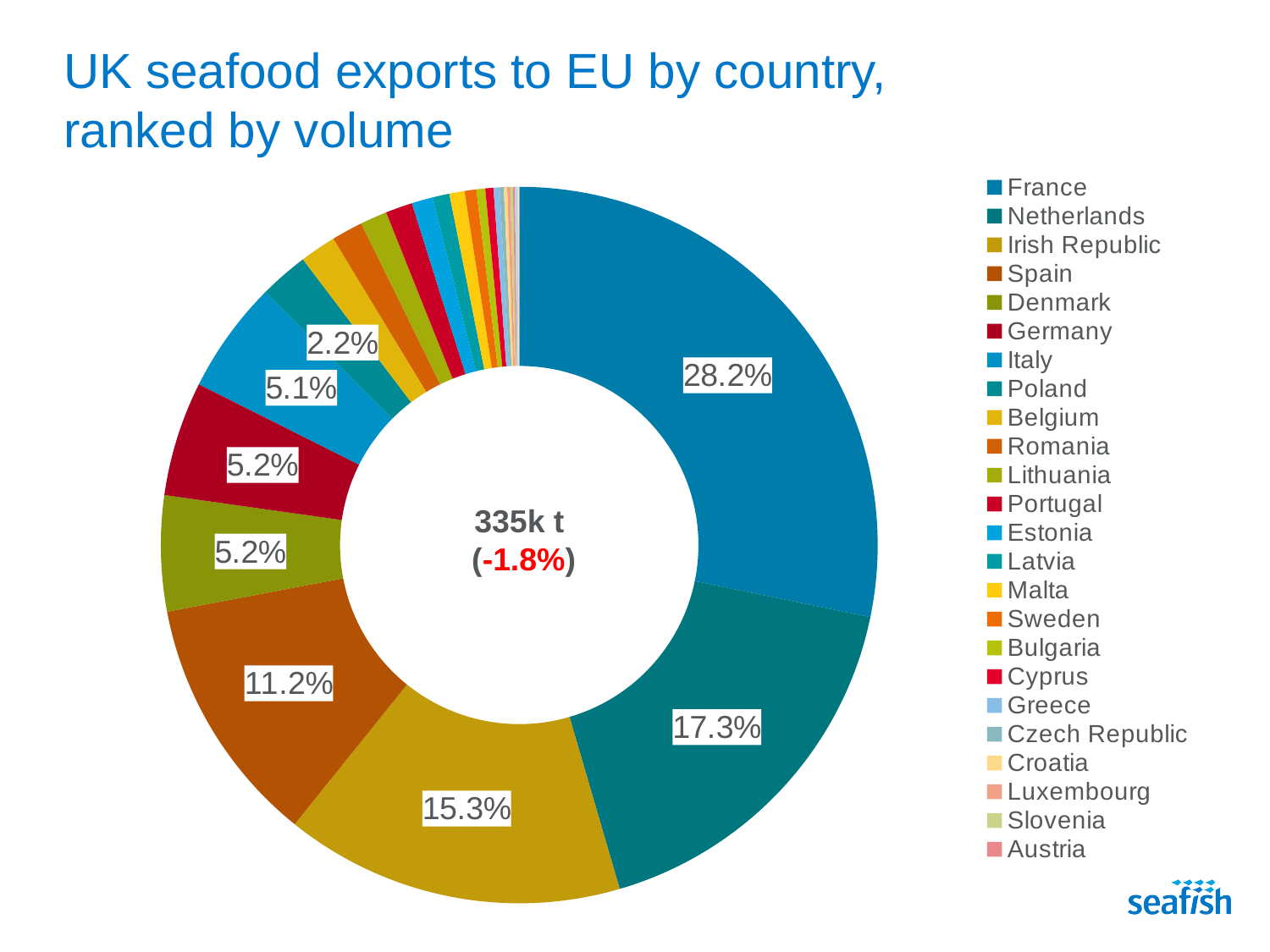
What share of UK seafood exports to the EU goes to Spain? 11.2% How many countries are listed in the chart legend? 24 What is the difference in share between France and the Netherlands? 10.9% What share of UK seafood exports to the EU goes to the Irish Republic? 15.3% What kind of chart is shown on the slide? Pie chart (doughnut) Which country receives the largest share of UK seafood exports to the EU? France Which receives a larger share of UK seafood exports, Spain or Italy? Spain What share of UK seafood exports to the EU goes to Poland? 2.2% What total volume is shown in the centre of the chart? 335k t What share of UK seafood exports to the EU goes to France? 28.2% What percentage change is shown in red in the centre of the chart? -1.8% What share of UK seafood exports to the EU goes to the Netherlands? 17.3%